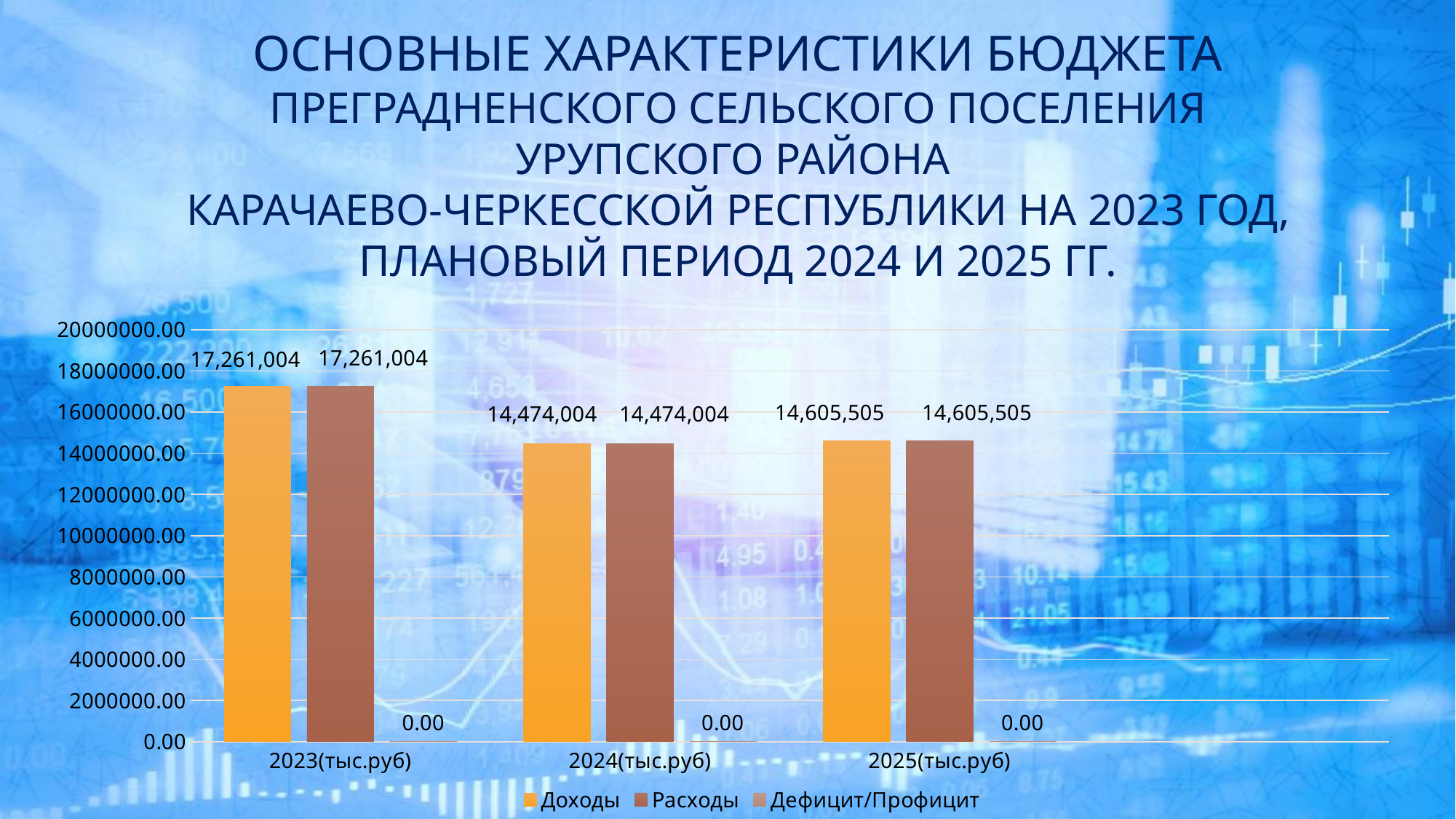
What is the value of Расходы for 2024(тыс.руб)? 14,474,004 In which category is Доходы the highest? 2023(тыс.руб) What is the value of Доходы for 2023(тыс.руб)? 17,261,004 Which series is shown in orange in the legend? Доходы What is the value of Доходы for 2025(тыс.руб)? 14,605,505 How many categories are shown on the x axis? 3 What is the difference between Доходы for 2023(тыс.руб) and Доходы for 2024(тыс.руб)? 2,787,000 How many series does the legend list? 3 Is the value of Расходы for 2025(тыс.руб) greater or less than 16000000.00? less In which category is Расходы the lowest? 2024(тыс.руб) What type of chart is shown on the slide? bar chart What is the value of Дефицит/Профицит for 2023(тыс.руб)? 0.00